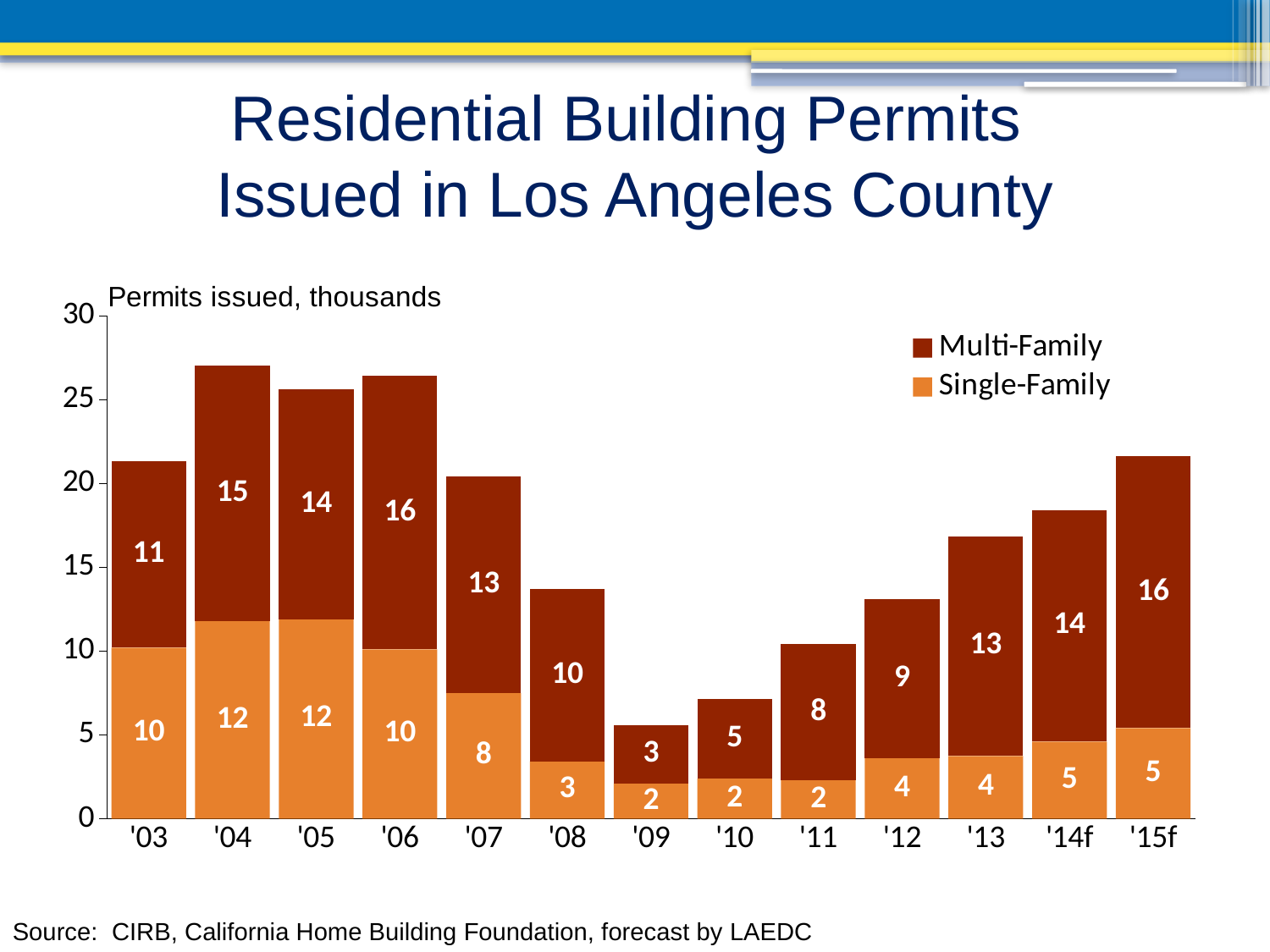
Which year has the lowest total stacked bar? '09 What is the Single-Family value for '14f? 5 How many series does the legend list? 2 What is the difference between the Multi-Family value for '15f and for '09? 13 Which is larger, the Single-Family value for '04 or for '07? '04 What is the Multi-Family value for '11? 8 How many years are shown on the x axis? 13 What kind of chart is shown on the slide? Stacked bar chart Is the total stacked bar for '04 greater or less than 25? greater What is the total of the stacked bar for '04, using the printed labels? 27 Which year has the lowest Multi-Family value? '09 What is the Multi-Family value for '07? 13